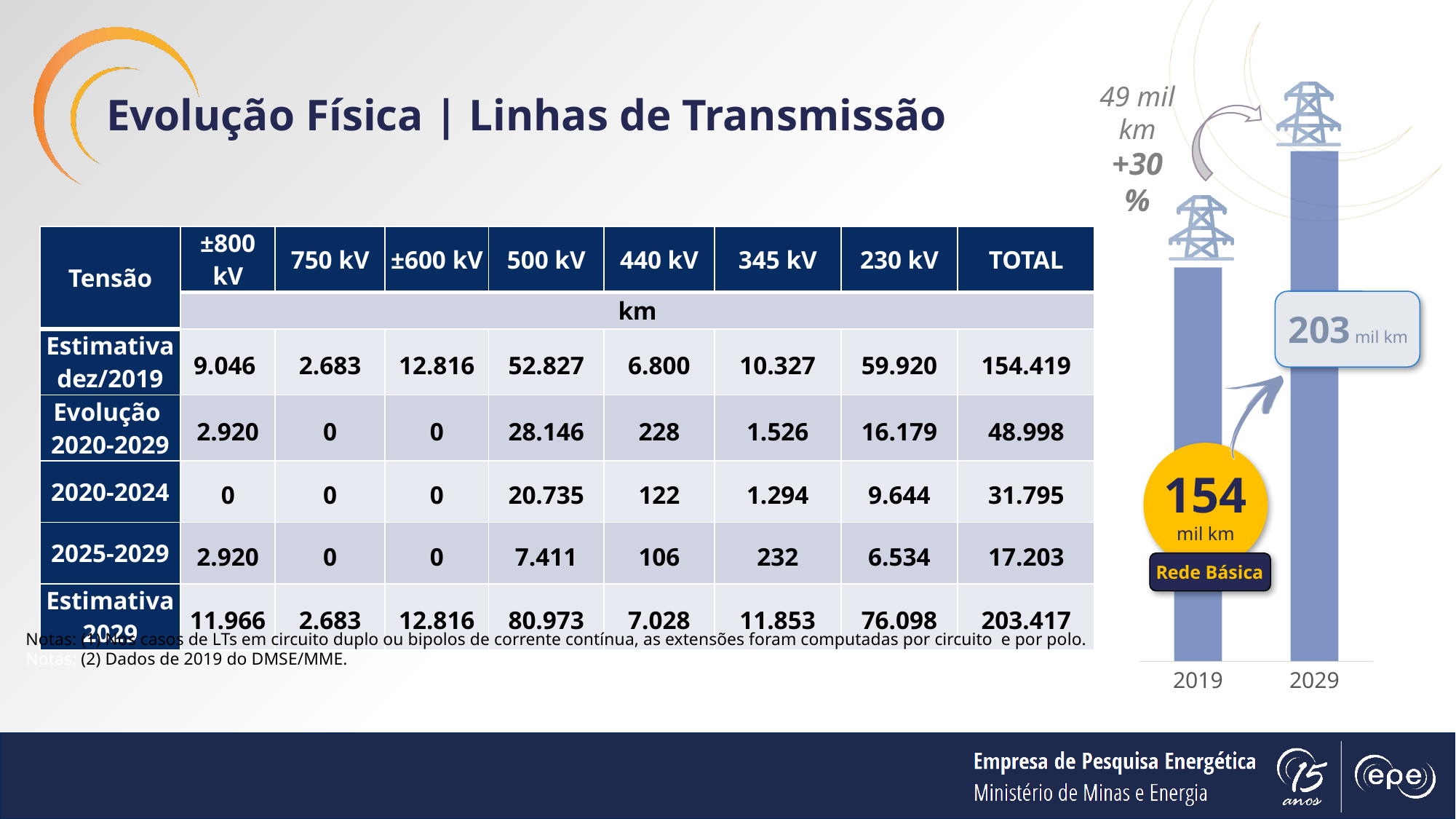
In the bar chart on the right, is the value for 2029 larger or smaller than the value for 2019? larger In the bar chart on the right, what value is shown for 2029? 203 mil km In the bar chart on the right, what percentage increase is annotated between 2019 and 2029? +30% What kind of chart is shown on the right side of the slide? bar chart In the bar chart on the right, do the values rise or fall from 2019 to 2029? rise In the bar chart on the right, which year has the shorter bar? 2019 How many bars does the chart on the right of the slide have? 2 What label appears below the yellow circle on the 2019 bar of the chart on the right? Rede Básica In the bar chart on the right, what is the difference between the 2029 and 2019 values? 49 mil km In the bar chart on the right, which year has the taller bar? 2029 In the bar chart on the right, what value is shown for 2019? 154 mil km